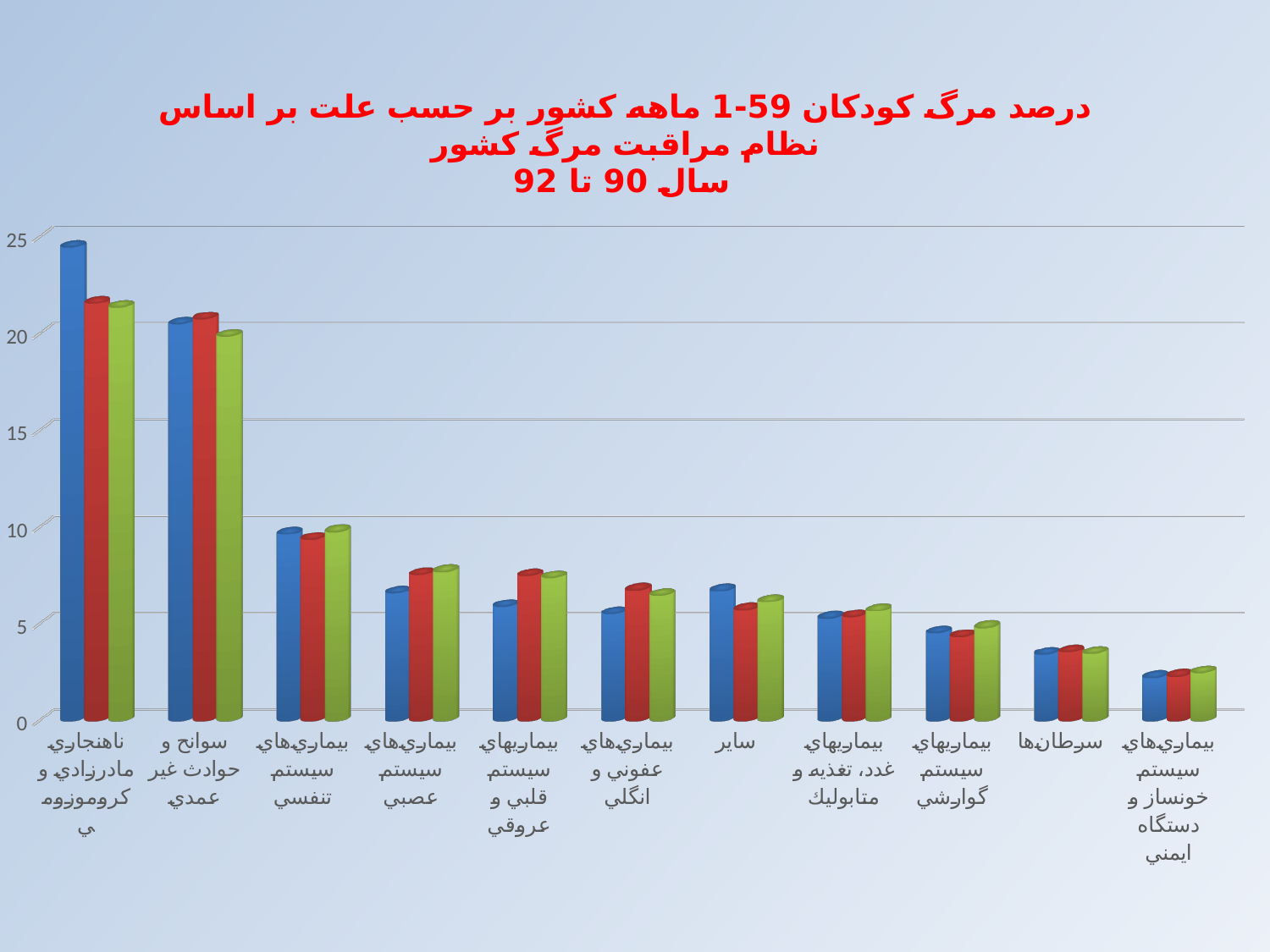
Is the value of the green bar for بيماري‌هاي سيستم تنفسي greater or less than 15? less Which has a higher blue bar: بيماري‌هاي سيستم تنفسي or سرطان‌ها? بيماري‌هاي سيستم تنفسي Which category has the lowest bars on the chart? بيماري‌هاي سيستم خونساز و دستگاه ايمني Is the value of the red bar for سوانح و حوادث غير عمدي greater or less than 15? greater Which category has the tallest bar on the chart? ناهنجاري مادرزادي و كروموزومي How many categories (causes of death) are shown on the x axis? 11 Is the value of the blue bar for سرطان‌ها greater or less than 5? less What kind of chart is shown on the slide? bar chart What years does the chart title say the data covers? سال 90 تا 92 Do the bar heights generally rise or fall moving from left to right along the x axis? fall Which has a higher blue bar: ناهنجاري مادرزادي و كروموزومي or سوانح و حوادث غير عمدي? ناهنجاري مادرزادي و كروموزومي